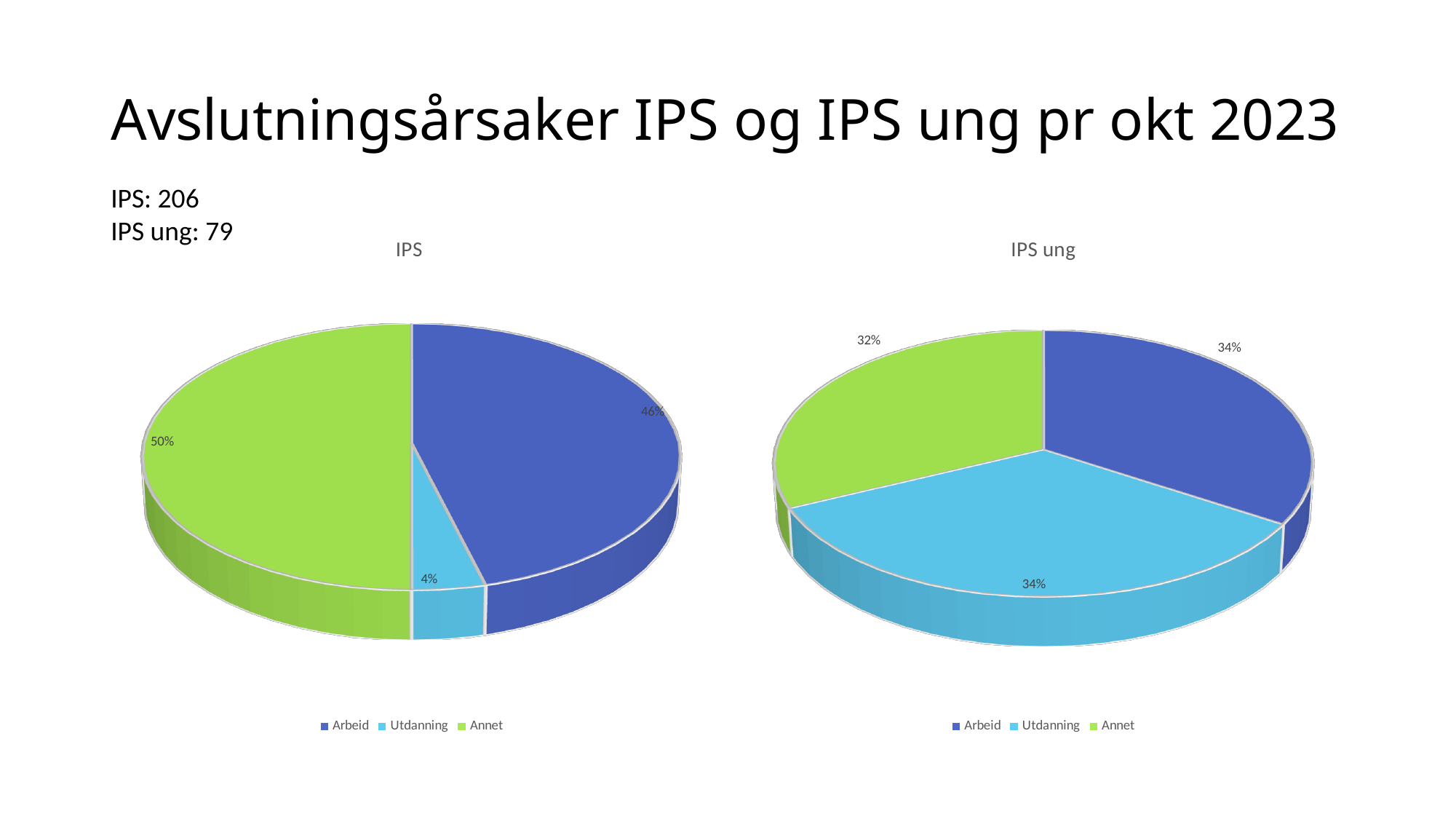
How many categories does the legend of the IPS chart list? 3 In the IPS chart, what share does Arbeid have? 46% In the IPS chart, which category has the smallest slice? Utdanning In the IPS chart, which category has the largest slice? Annet In the IPS chart, what share does Utdanning have? 4% In the IPS chart, what share does Annet have? 50% What kind of chart is the IPS ung chart? Pie chart In the IPS chart, what is the difference in percentage points between Annet and Arbeid? 4 In the IPS ung chart, which is larger, Arbeid or Annet? Arbeid What is the title of the chart on the right? IPS ung